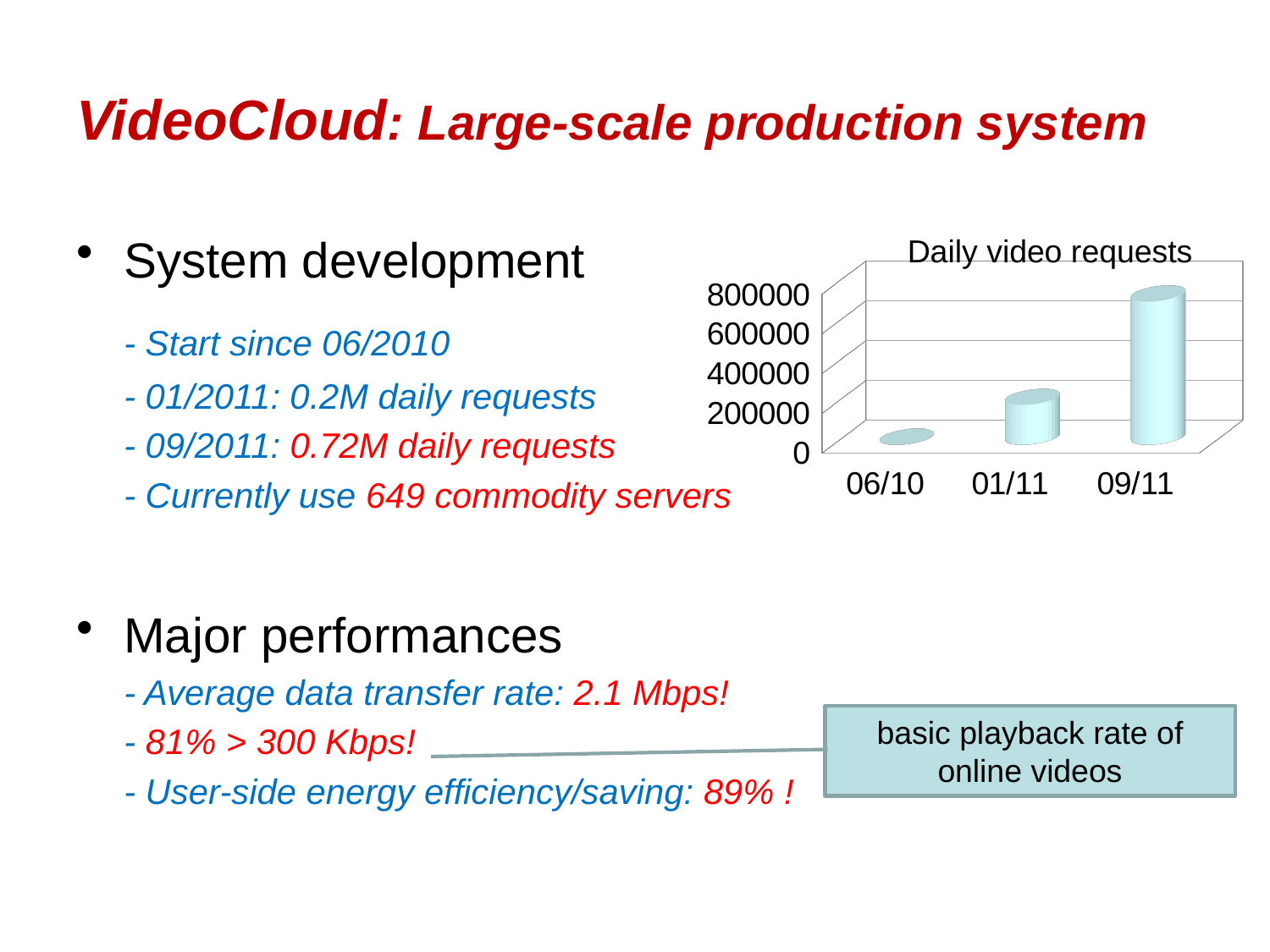
How many categories are shown on the x axis of the chart? 3 Do the values in the Daily video requests chart rise or fall from 06/10 to 09/11? rise Which is larger in the chart, the value for 01/11 or the value for 09/11? 09/11 Is the value for 01/11 greater or less than 400000? less What kind of chart is shown on the slide? bar chart Which is larger in the chart, the value for 06/10 or the value for 01/11? 01/11 Is the value for 09/11 greater or less than 800000? less Is the value for 06/10 greater or less than 200000? less What is the title of the chart? Daily video requests Which category has the lowest value in the Daily video requests chart? 06/10 Which category has the highest value in the Daily video requests chart? 09/11